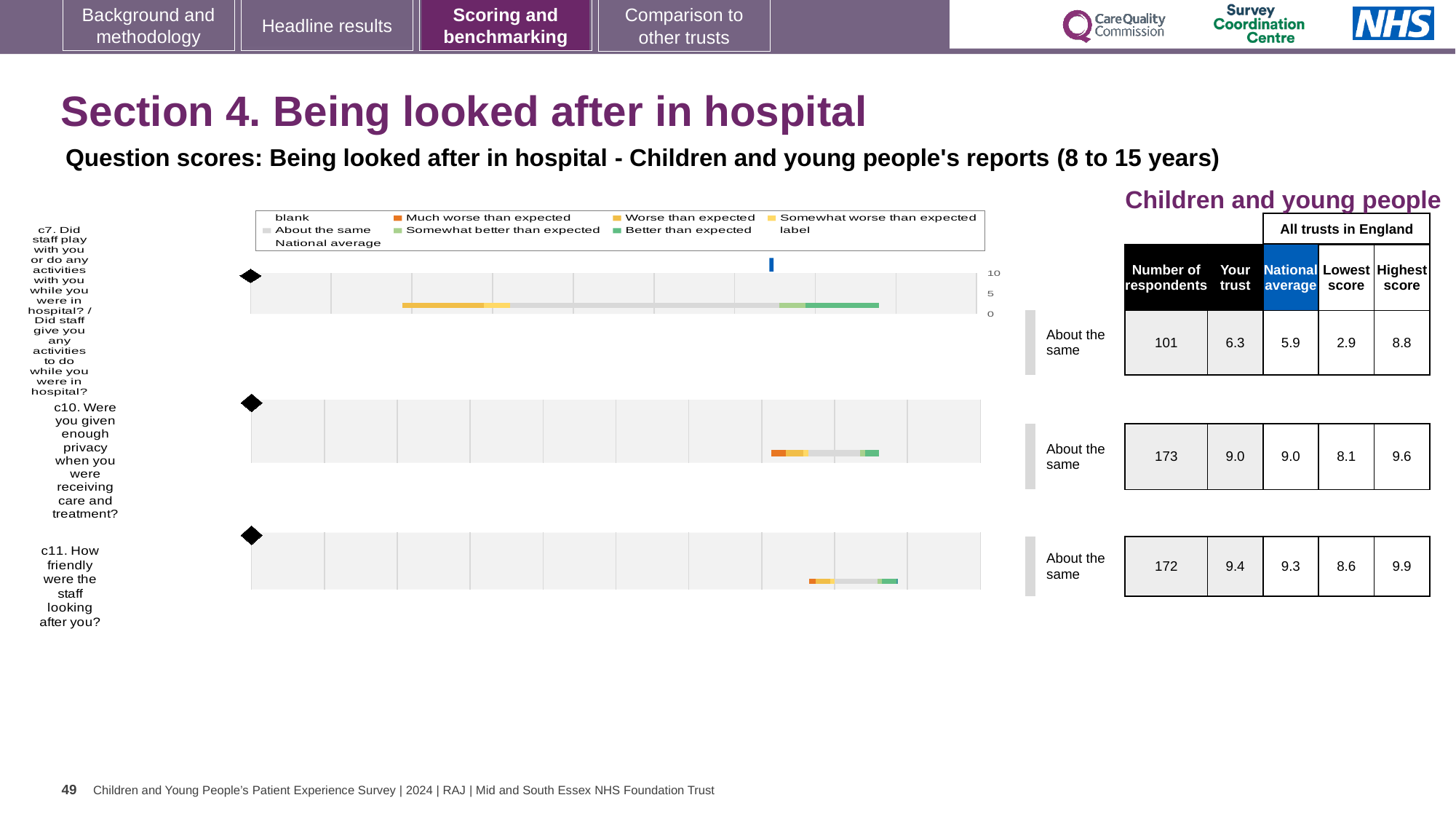
What is the difference between the 'Your trust' score and the national average for question c7? 0.4 What is the highest score across all trusts in England for question c11 (How friendly were the staff looking after you?)? 9.9 What is the difference between the highest and lowest scores across all trusts in England for question c11? 1.3 For question c11, which is larger: the 'Your trust' score or the national average? Your trust What benchmark category is shown next to the chart for question c10? About the same Which question has the lowest number of respondents? c7 What is the national average score for question c10 (Were you given enough privacy when you were receiving care and treatment?)? 9.0 What is the 'Your trust' score for question c7 (Did staff play with you or do any activities with you while you were in hospital?)? 6.3 How many questions (c7, c10, c11) are plotted on the slide? 3 How many respondents answered question c7? 101 What kind of chart is used to show the question scores for c7, c10 and c11? bar chart Which question has the highest 'Your trust' score? c11